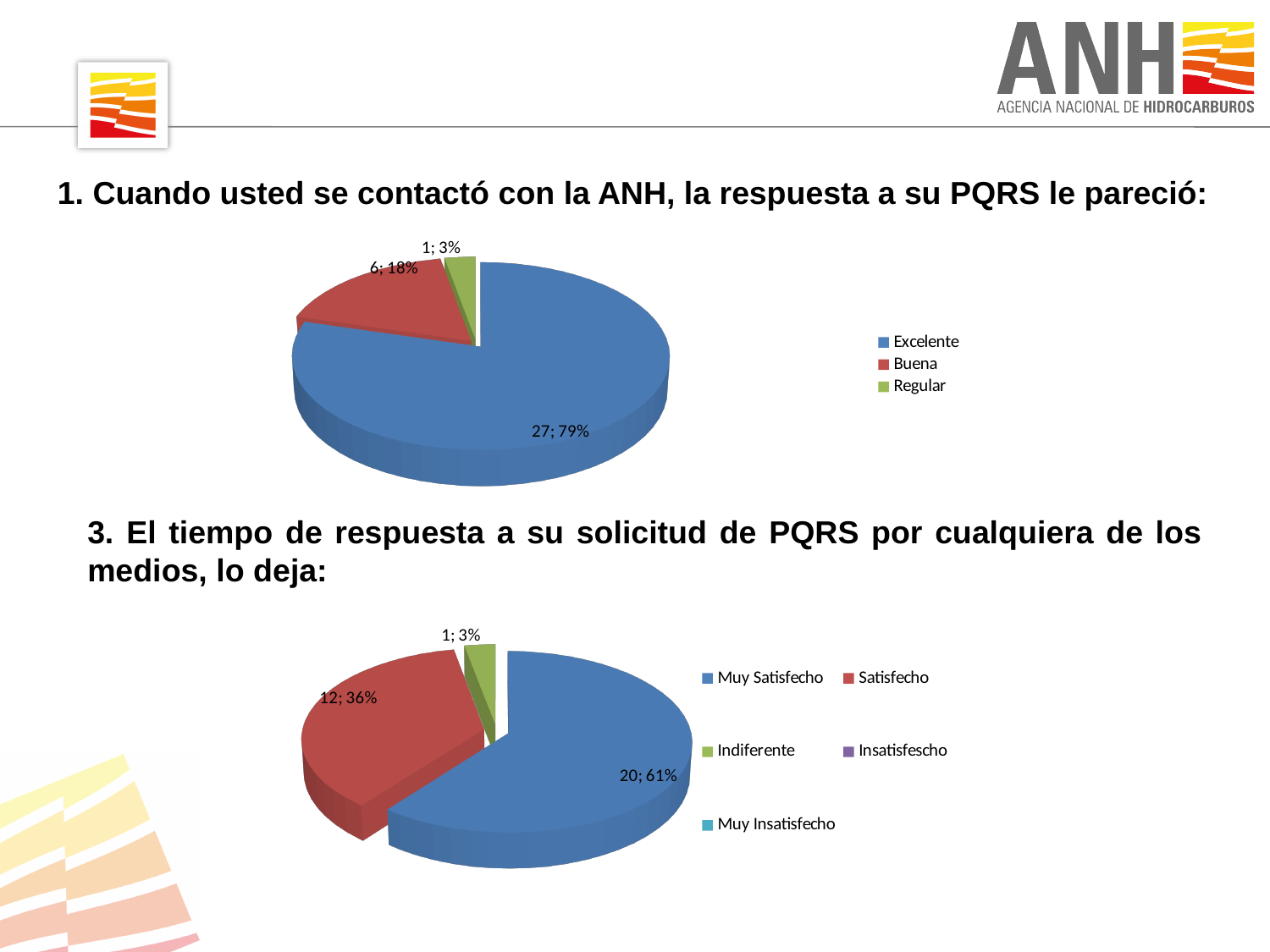
In the bottom pie chart (question 3), what is the count and share for Muy Satisfecho? 20; 61% In the top pie chart (question 1), what share of responses is Buena? 18% In the bottom pie chart (question 3), what share of responses is Satisfecho? 36% What type of chart is used for question 1 at the top of the slide? Pie chart In the bottom pie chart (question 3), which colour represents Indiferente? Green In the top pie chart (question 1), how many categories does the legend list? 3 In the top pie chart (question 1), which category has the smallest slice? Regular In the bottom pie chart (question 3), how many entries does the legend list? 5 In the bottom pie chart (question 3), which category has the largest slice? Muy Satisfecho In the top pie chart (question 1), what is the count and share for Excelente? 27; 79% In the bottom pie chart (question 3), what is the difference in count between Muy Satisfecho and Satisfecho? 8 In the top pie chart (question 1), how many more responses are Excelente than Buena? 21